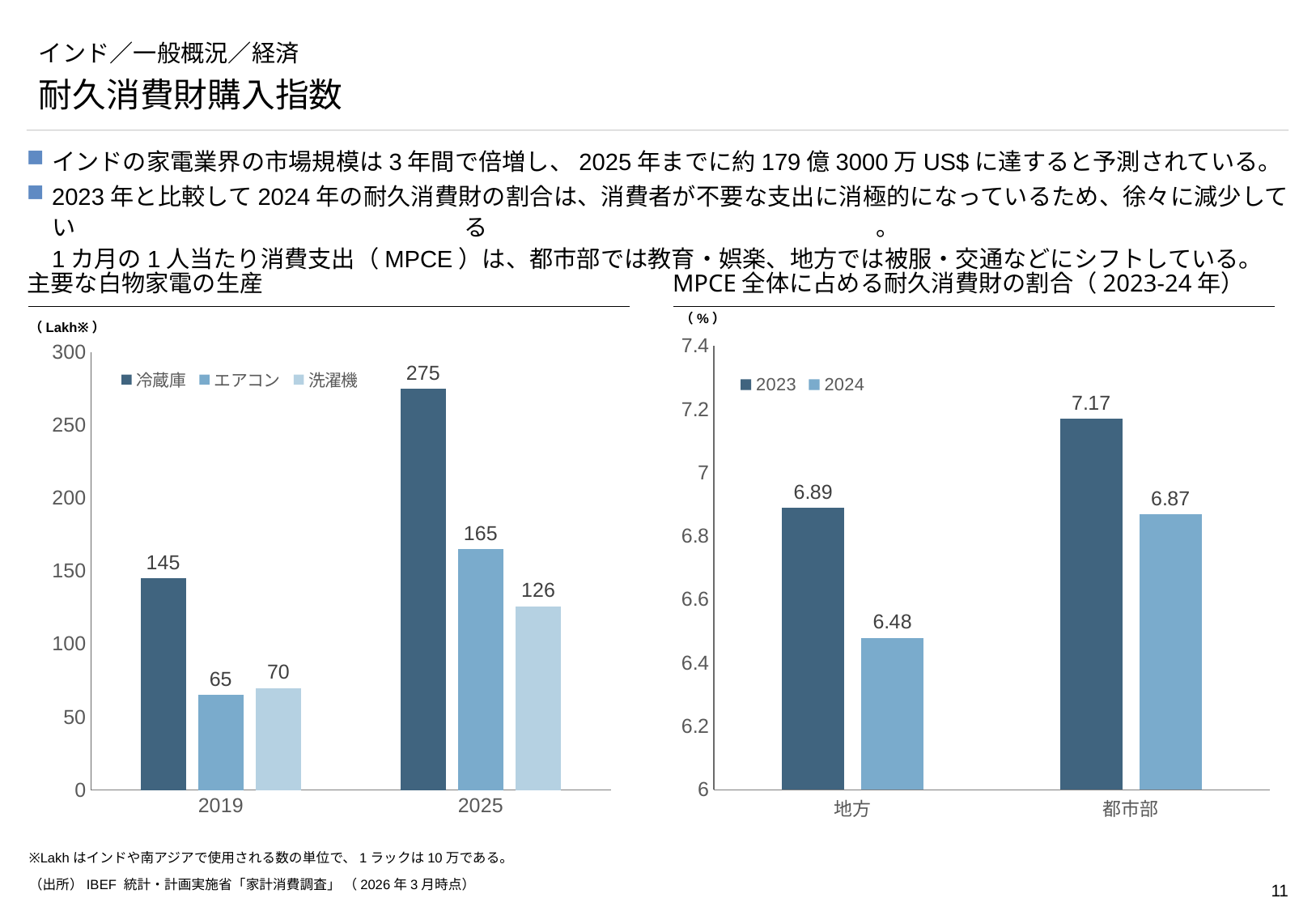
In the left chart (主要な白物家電の生産), what is the value for 冷蔵庫 in 2025? 275 In the right chart (MPCE全体に占める耐久消費財の割合), what is the value for 2024 in 地方? 6.48 In the right chart (MPCE全体に占める耐久消費財の割合), which is larger in 都市部: 2023 or 2024? 2023 In the left chart (主要な白物家電の生産), which series has the highest value in 2025? 冷蔵庫 In the left chart (主要な白物家電の生産), what is the value for エアコン in 2019? 65 In the right chart (MPCE全体に占める耐久消費財の割合), how many categories are shown on the x axis? 2 In the left chart (主要な白物家電の生産), does the value for 洗濯機 rise or fall from 2019 to 2025? rise In the right chart (MPCE全体に占める耐久消費財の割合), what is the value for 2023 in 都市部? 7.17 In the left chart (主要な白物家電の生産), what is the difference between 冷蔵庫 in 2025 and 冷蔵庫 in 2019? 130 In the right chart (MPCE全体に占める耐久消費財の割合), what is the difference between 2023 and 2024 in 地方? 0.41 What kind of chart is the right chart (MPCE全体に占める耐久消費財の割合)? bar chart In the left chart (主要な白物家電の生産), how many series does the legend list? 3